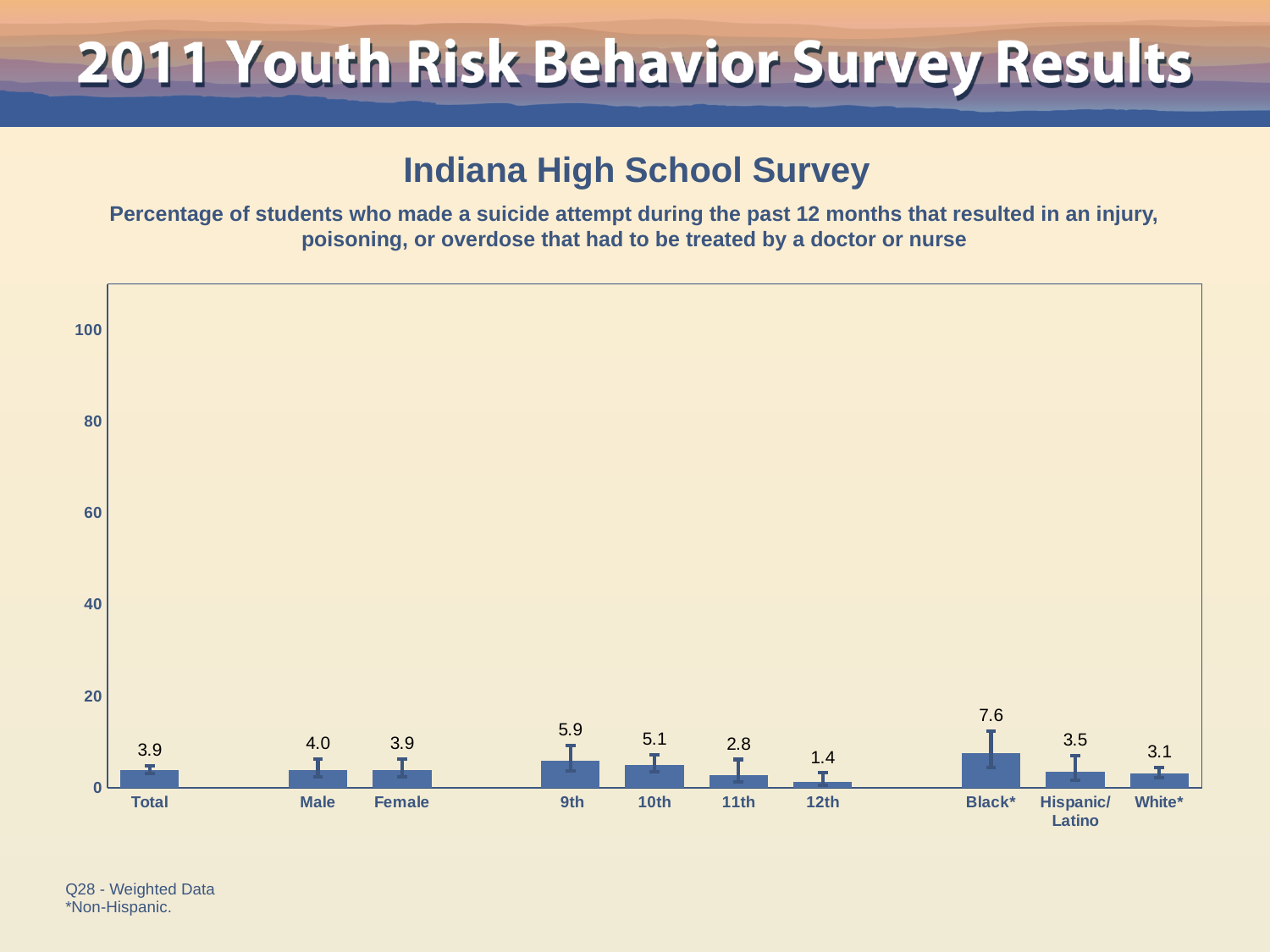
What is the value for Total? 3.9 How many categories are shown on the x axis? 10 What kind of chart is this? bar chart Which category has the lowest value? 12th What is the difference between the values for 9th and 12th? 4.5 What is the value for Hispanic/Latino? 3.5 What is the value for 12th? 1.4 What is the value for Black*? 7.6 What is the difference between the values for Black* and White*? 4.5 Which is larger, the value for 10th or the value for 11th? 10th Which category has the highest value? Black* Is the value for Black* greater or less than 20? less